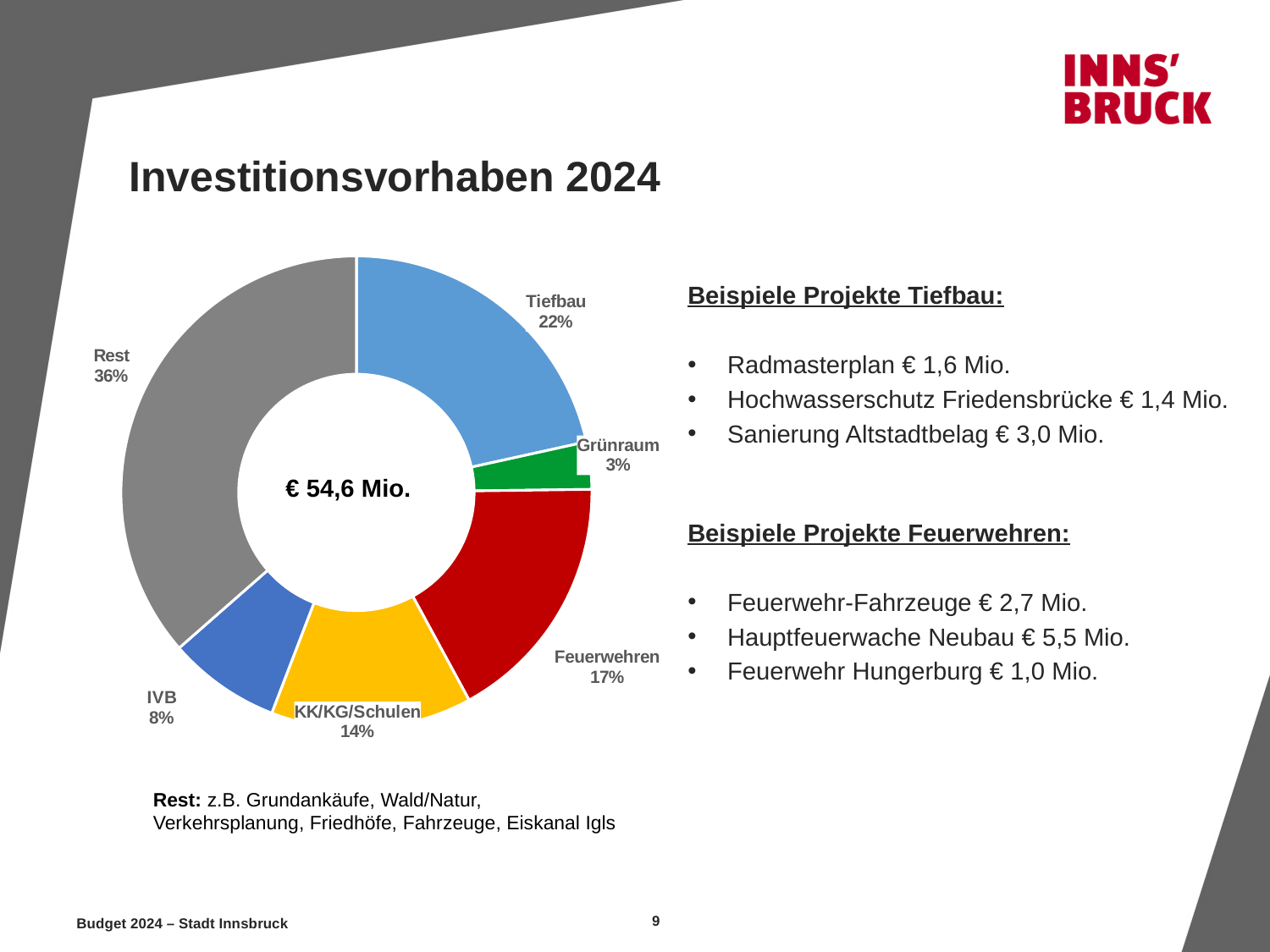
How many categories are shown in the chart? 6 What is the difference in percentage points between Tiefbau and Feuerwehren? 5 What share of the donut chart does Tiefbau represent? 22% Which category has the largest share in the chart? Rest What total amount is shown in the centre of the chart? € 54,6 Mio. Which category has the smallest share in the chart? Grünraum What percentage is shown for KK/KG/Schulen in the chart? 14% What percentage is shown for Feuerwehren in the chart? 17% Which has a larger share, KK/KG/Schulen or IVB? KK/KG/Schulen What colour is the Grünraum segment in the chart? Green What kind of chart is shown on the slide? Donut (pie) chart What percentage is shown for IVB in the chart? 8%